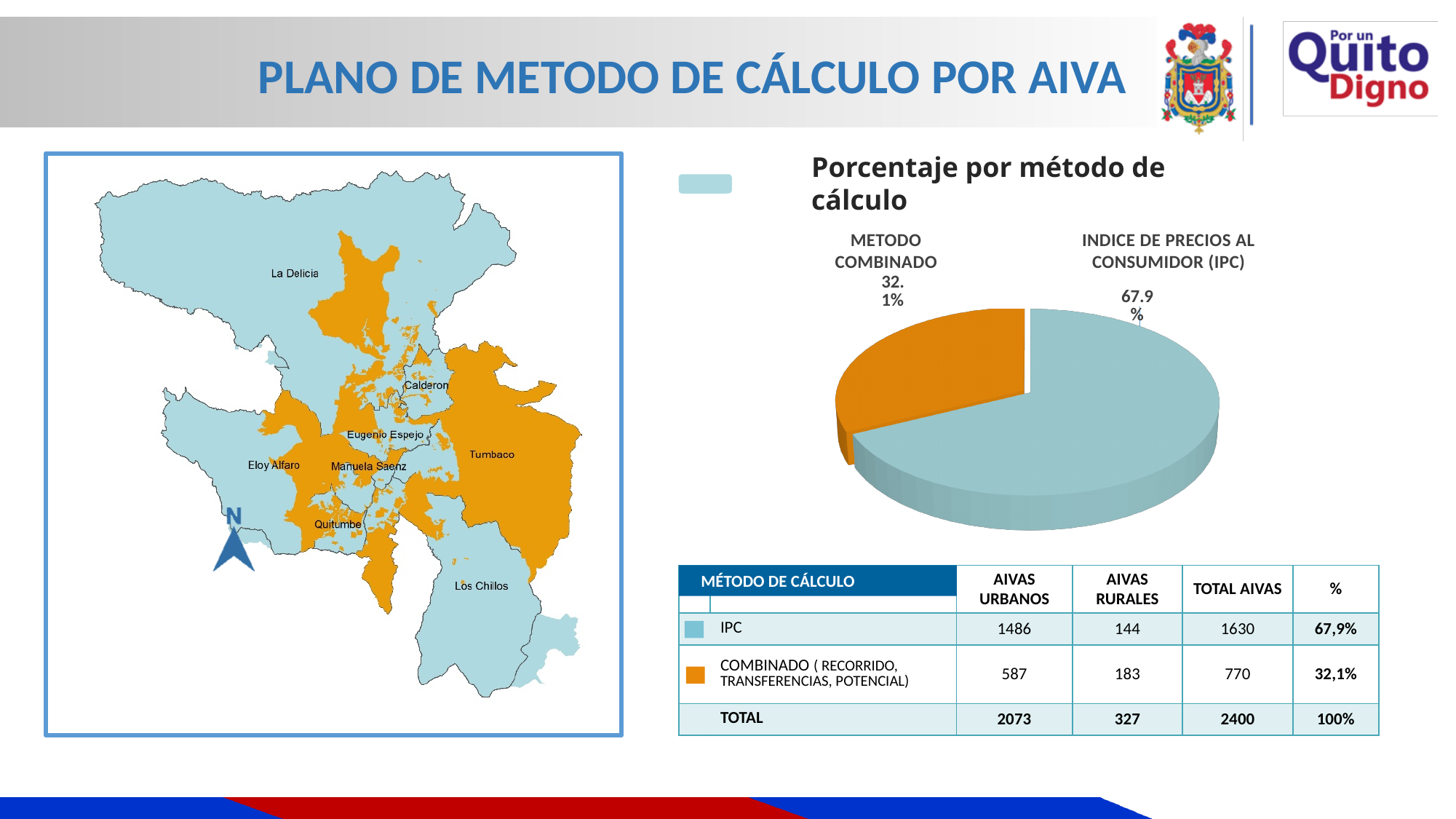
Which slice of the pie chart is the smallest? METODO COMBINADO What is the difference in percentage points between the IPC slice and the METODO COMBINADO slice in the pie chart? 35.8 In the pie chart, what percentage is shown for METODO COMBINADO? 32.1% What kind of chart is shown under the title "Porcentaje por método de cálculo"? pie chart What colour is the METODO COMBINADO slice in the pie chart? orange Which slice of the pie chart is the largest? INDICE DE PRECIOS AL CONSUMIDOR (IPC) What is the title of the pie chart? Porcentaje por método de cálculo Is the IPC slice of the pie chart greater or less than half of the pie? greater Which is larger in the pie chart, the IPC slice or the METODO COMBINADO slice? IPC In the pie chart, what percentage is shown for INDICE DE PRECIOS AL CONSUMIDOR (IPC)? 67.9% How many slices does the pie chart have? 2